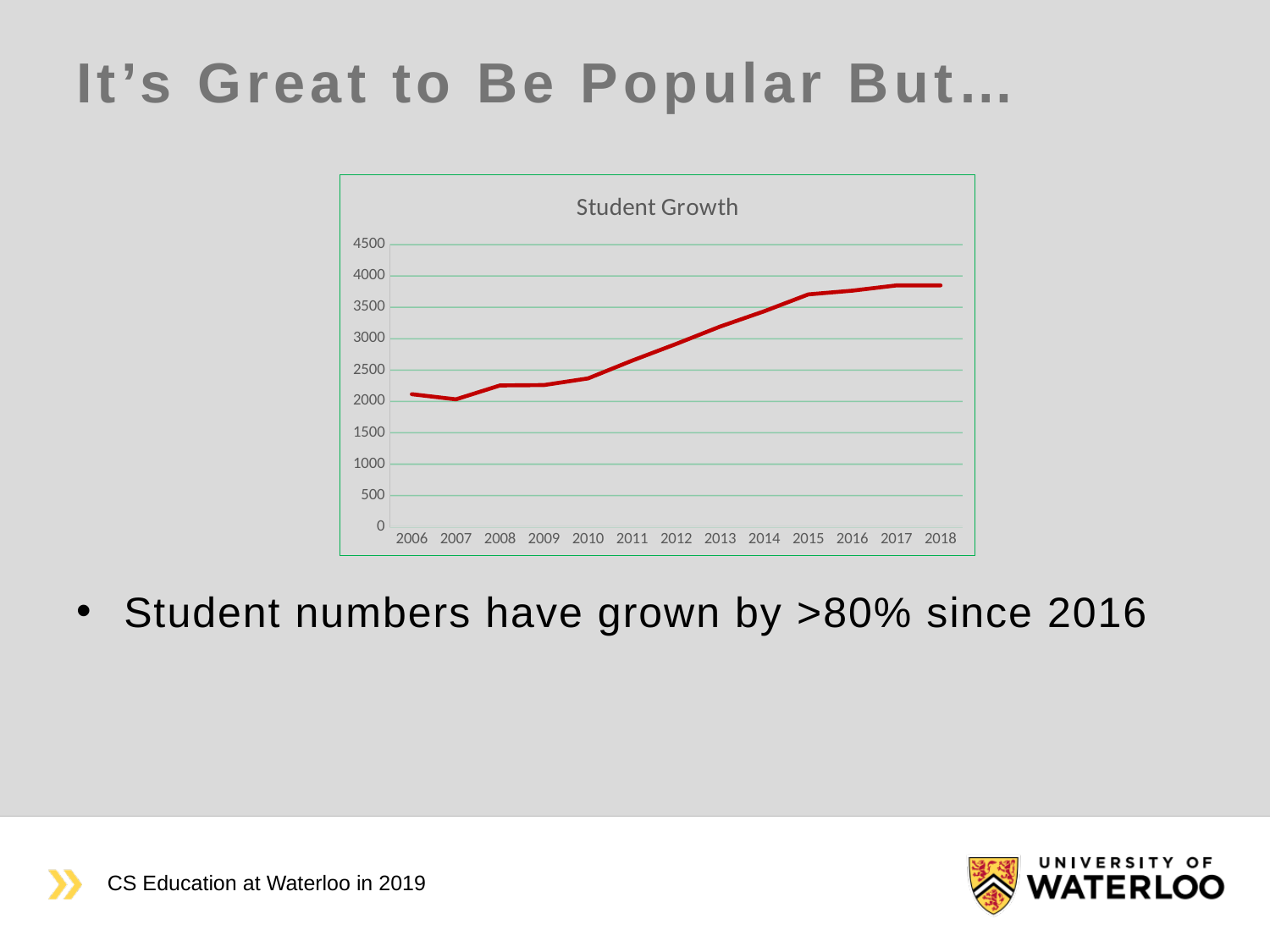
Is the value for 2006 greater or less than 2000? greater Do the values generally rise or fall from 2007 to 2018? rise Which year has the lowest value in the chart? 2007 What is the title of the chart? Student Growth How many years are plotted on the x axis of the chart? 13 Is the value for 2015 greater or less than 4000? less Is the value for 2018 greater or less than 3500? greater Which year has the larger value, 2012 or 2009? 2012 What type of chart is shown on the slide? line chart